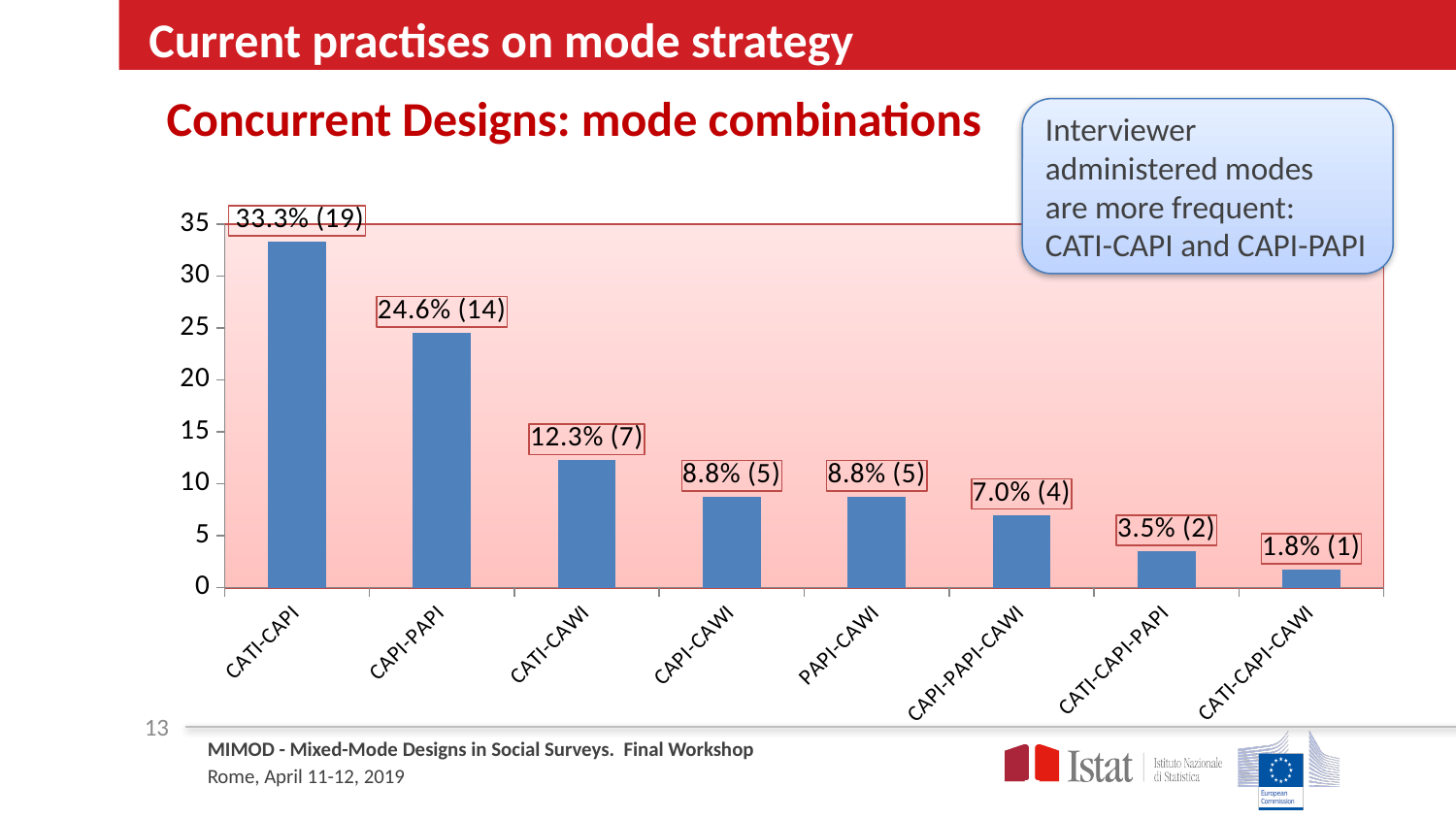
Is the value for CAPI-PAPI greater or less than 20? greater What is the data label shown for CATI-CAWI? 12.3% (7) Do the values rise or fall from left to right along the x axis? fall Which is larger, the value for CATI-CAWI or the value for CAPI-CAWI? CATI-CAWI What is the difference in percentage points between CATI-CAPI and CAPI-PAPI? 8.7 What is the data label shown for CATI-CAPI? 33.3% (19) Which mode combination has the highest value? CATI-CAPI What is the data label shown for CAPI-PAPI-CAWI? 7.0% (4) What is the title of the chart? Concurrent Designs: mode combinations Which mode combination has the lowest value? CATI-CAPI-CAWI How many mode combinations are shown on the x axis? 8 What kind of chart is shown on the slide? bar chart